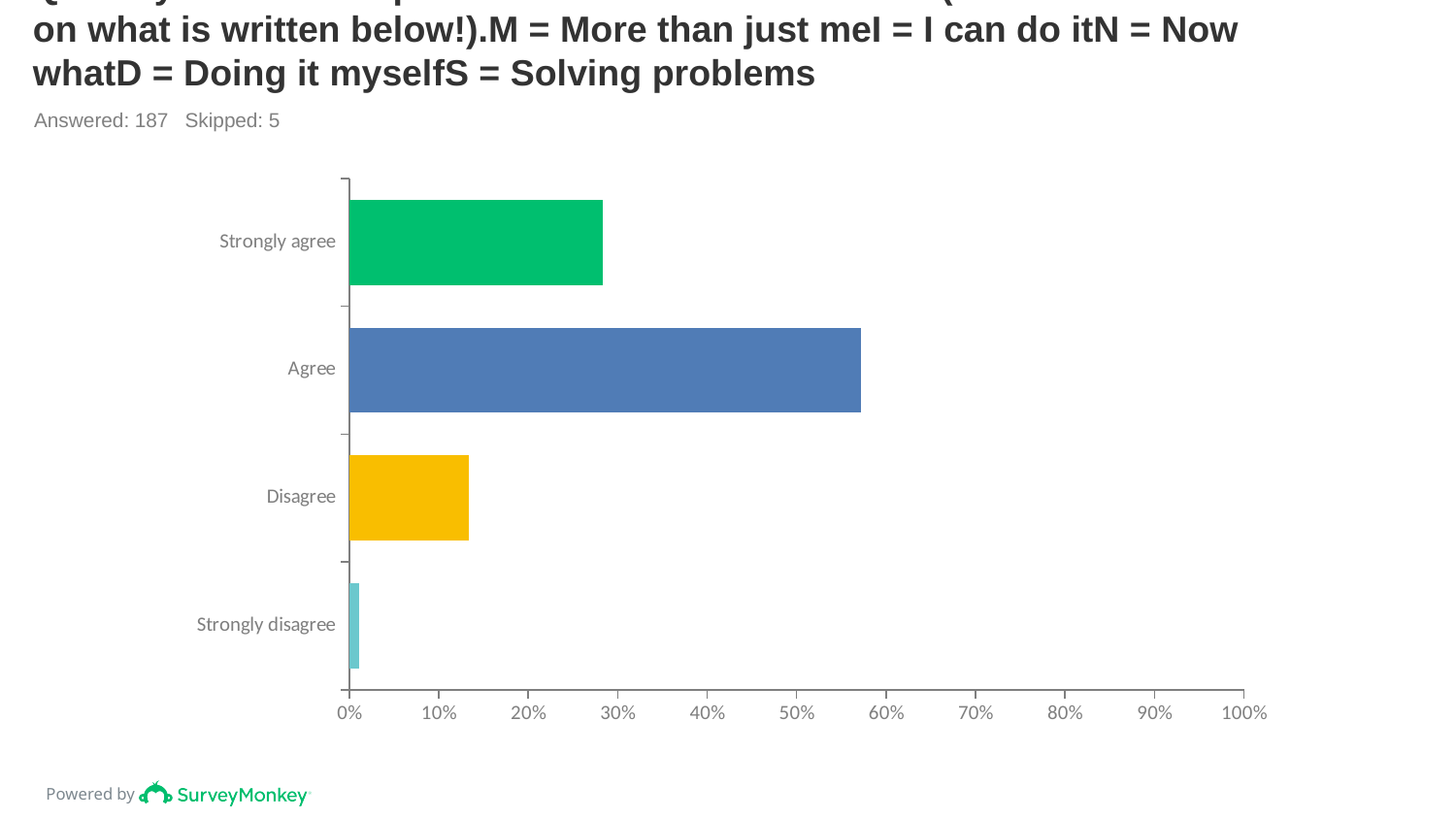
Which is larger, the value for Strongly agree or the value for Disagree? Strongly agree Is the value for Disagree greater or less than 10%? greater Is the value for Strongly agree greater or less than 20%? greater Which response category has the lowest value? Strongly disagree Is the value for Agree greater or less than 50%? greater Which is larger, the value for Agree or the value for Strongly agree? Agree How many response categories are plotted in the chart? 4 Which response category has the highest value? Agree What colour is the bar for Agree? blue What kind of chart is shown on the slide? bar chart